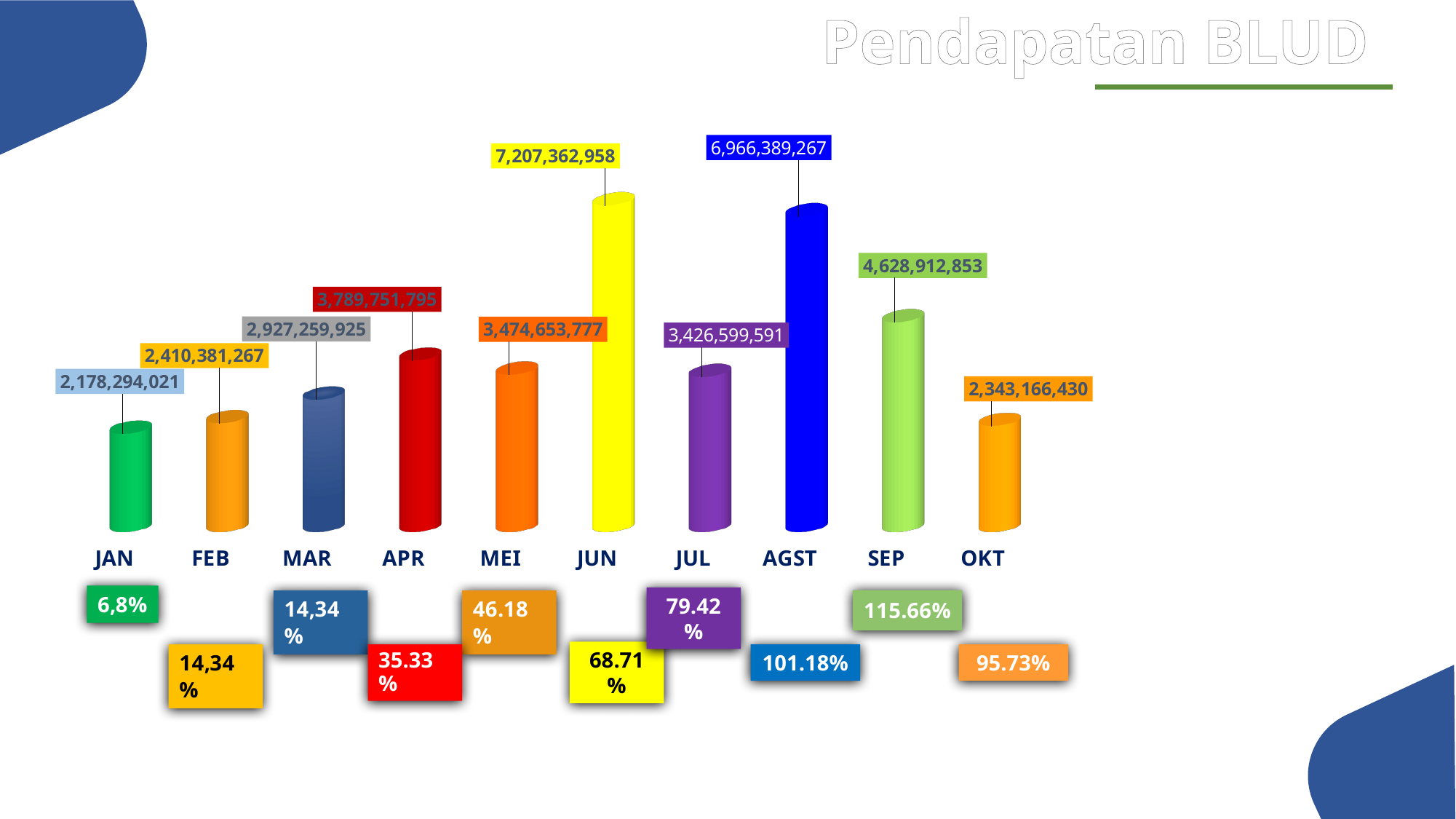
What is the difference between the values for FEB and JAN? 232,087,246 What is the value for SEP? 4,628,912,853 What is the title of the slide? Pendapatan BLUD Which month has the highest value? JUN What is the value for JAN? 2,178,294,021 How many months are shown on the chart? 10 What is the difference between the values for JUN and AGST? 240,973,691 Which is larger, the value for APR or the value for MEI? APR Which is larger, the value for SEP or the value for OKT? SEP What kind of chart is shown on the slide? bar chart Which month has the lowest value? JAN What is the value for JUN? 7,207,362,958